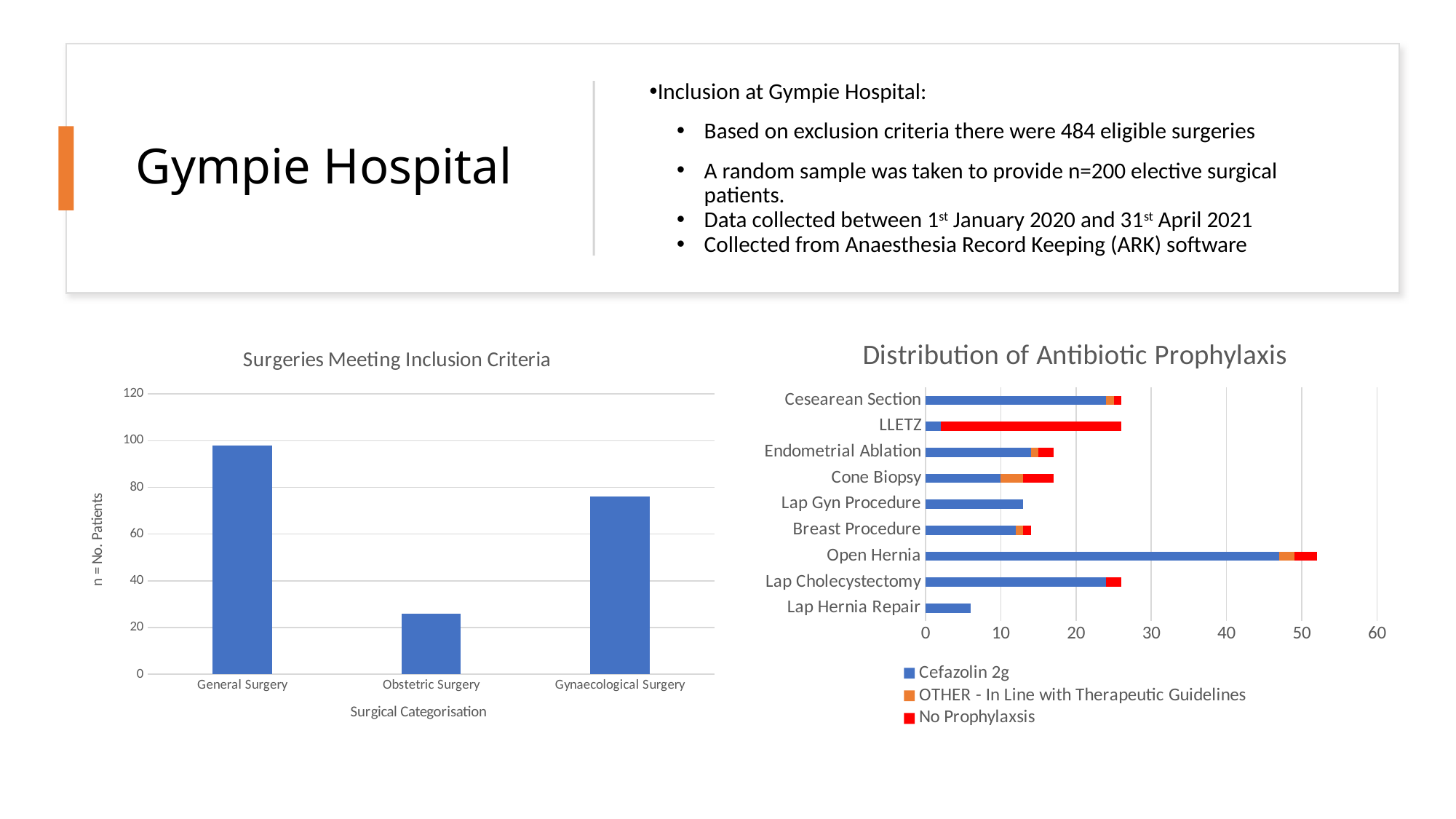
On the 'Surgeries Meeting Inclusion Criteria' chart, is the value for Obstetric Surgery greater or less than 40? less On the 'Surgeries Meeting Inclusion Criteria' chart, which category has the highest value? General Surgery What type of chart is the 'Surgeries Meeting Inclusion Criteria' chart? bar chart On the 'Surgeries Meeting Inclusion Criteria' chart, which category has the lowest value? Obstetric Surgery How many series does the legend list on the 'Distribution of Antibiotic Prophylaxis' chart? 3 On the 'Distribution of Antibiotic Prophylaxis' chart, which procedure has the longest total bar? Open Hernia On the 'Distribution of Antibiotic Prophylaxis' chart, is the total bar for Lap Hernia Repair greater or less than 10? less On the 'Distribution of Antibiotic Prophylaxis' chart, which series is shown in red? No Prophylaxsis How many procedure categories are shown on the 'Distribution of Antibiotic Prophylaxis' chart? 9 On the 'Surgeries Meeting Inclusion Criteria' chart, is the value for Gynaecological Surgery greater or less than 60? greater How many categories are shown on the 'Surgeries Meeting Inclusion Criteria' chart? 3 On the 'Surgeries Meeting Inclusion Criteria' chart, what is the y-axis label? n = No. Patients